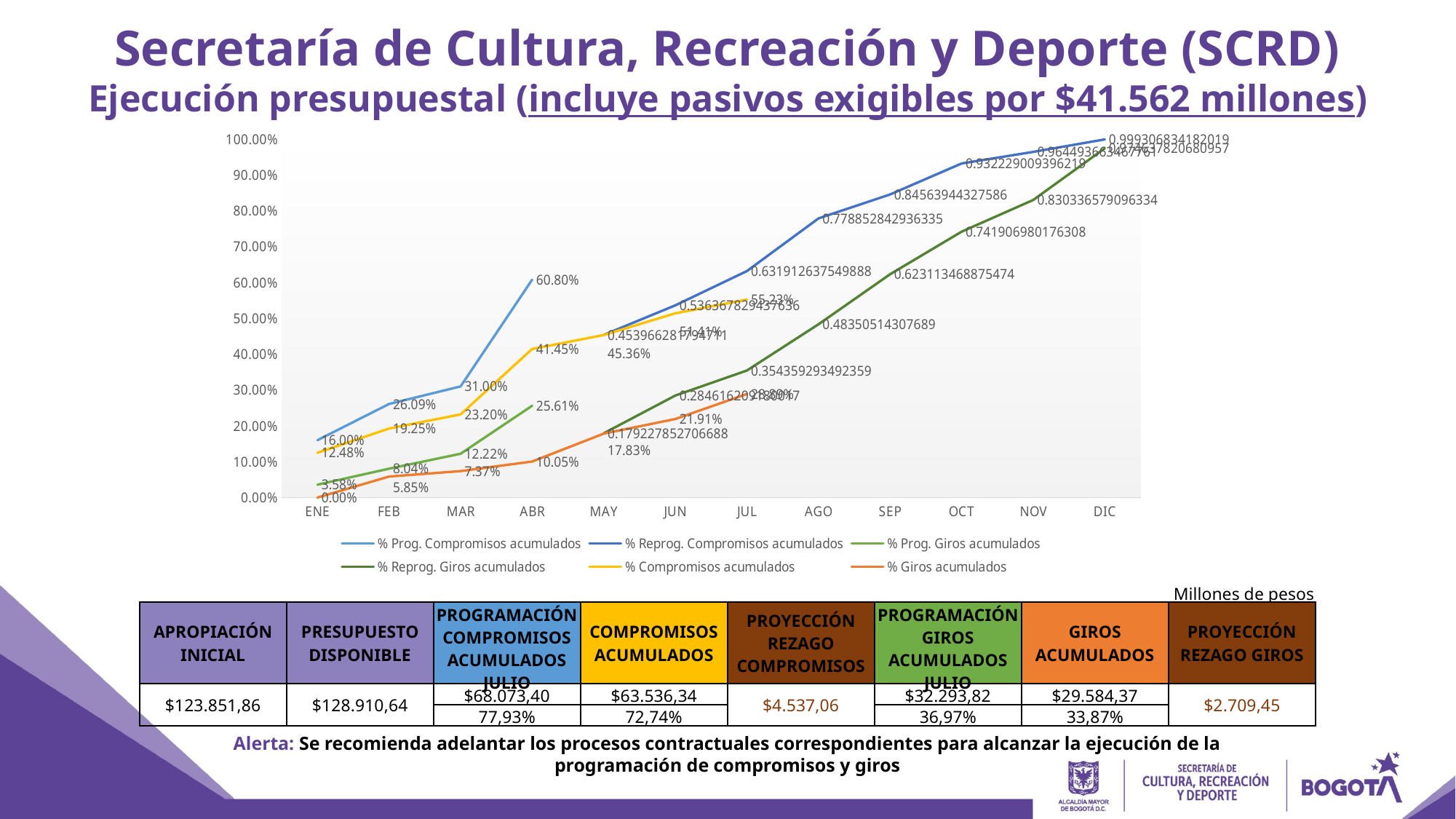
What kind of chart is shown on the slide? line chart Is the value for % Reprog. Compromisos acumulados in SEP greater or less than 80%? greater How many months are shown along the x axis of the chart? 12 In ABR, what is the difference between % Prog. Compromisos acumulados (60.80%) and % Compromisos acumulados (41.45%)? 19.35 percentage points In ABR, which is larger: % Prog. Giros acumulados or % Giros acumulados? % Prog. Giros acumulados How many series does the chart legend list? 6 What is the value of % Prog. Compromisos acumulados in ABR? 60.80% Does the % Reprog. Giros acumulados line rise or fall from MAY to DIC? rise What is the value of % Compromisos acumulados in JUL? 55.23% What is the data label for % Reprog. Compromisos acumulados in OCT? 0.932229009396219 What is the value of % Giros acumulados in MAY? 17.83% What is the data label for % Reprog. Giros acumulados in DIC? 0.974617820680957